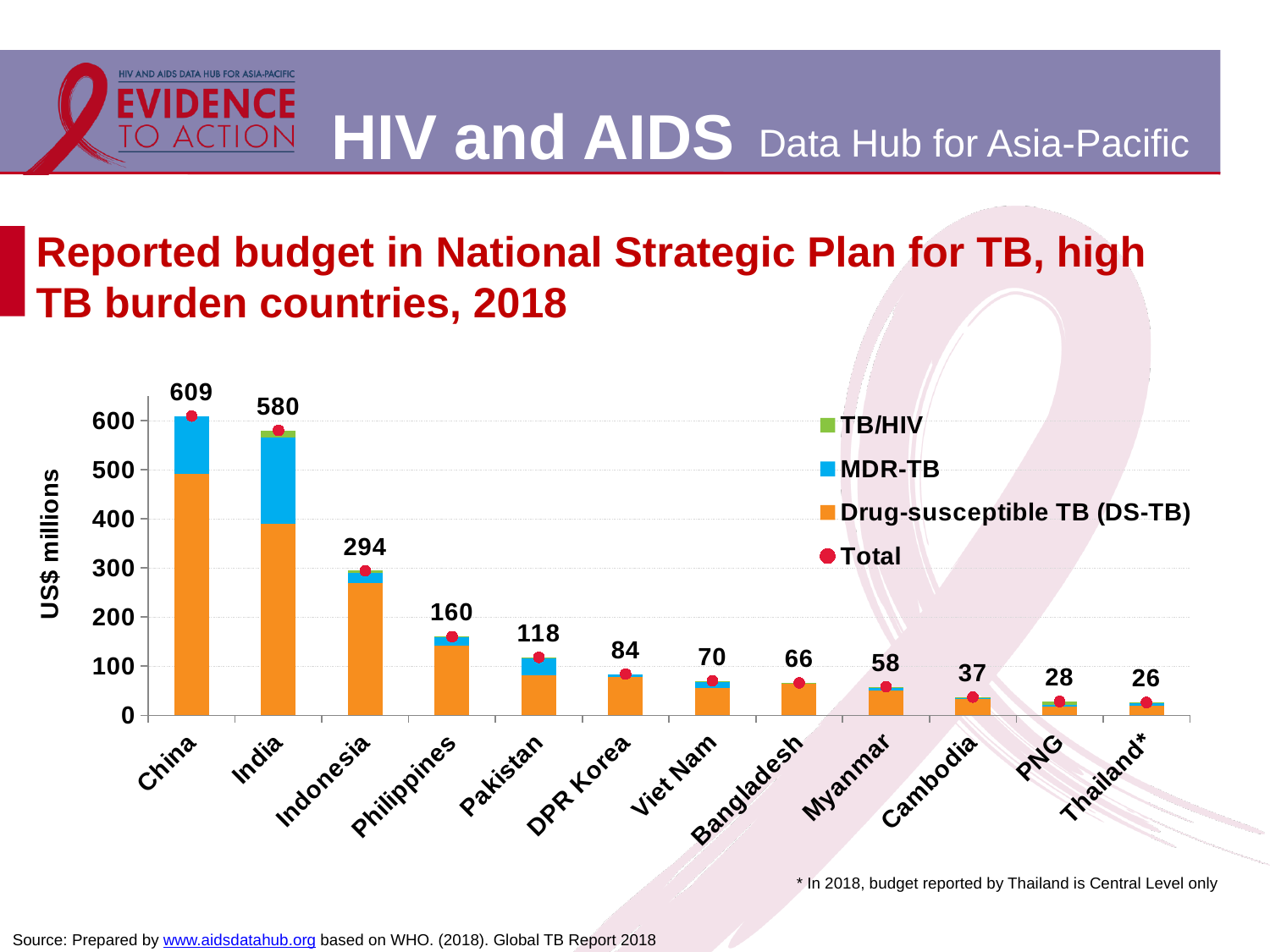
How many entries does the legend list? 4 Which has a larger total budget, Viet Nam or Bangladesh? Viet Nam What is the difference between the total budgets of Philippines and Pakistan? 42 What is the total reported budget for Myanmar? 58 Which country has the highest total reported budget? China What is the total reported budget for Indonesia? 294 What is the total reported budget for China? 609 Is the Drug-susceptible TB (DS-TB) value for China greater or less than 400? greater How many countries are shown on the x axis? 12 What is the difference between the total budgets of China and India? 29 What kind of chart is shown on the slide? Stacked bar chart Which country has the lowest total reported budget? Thailand*